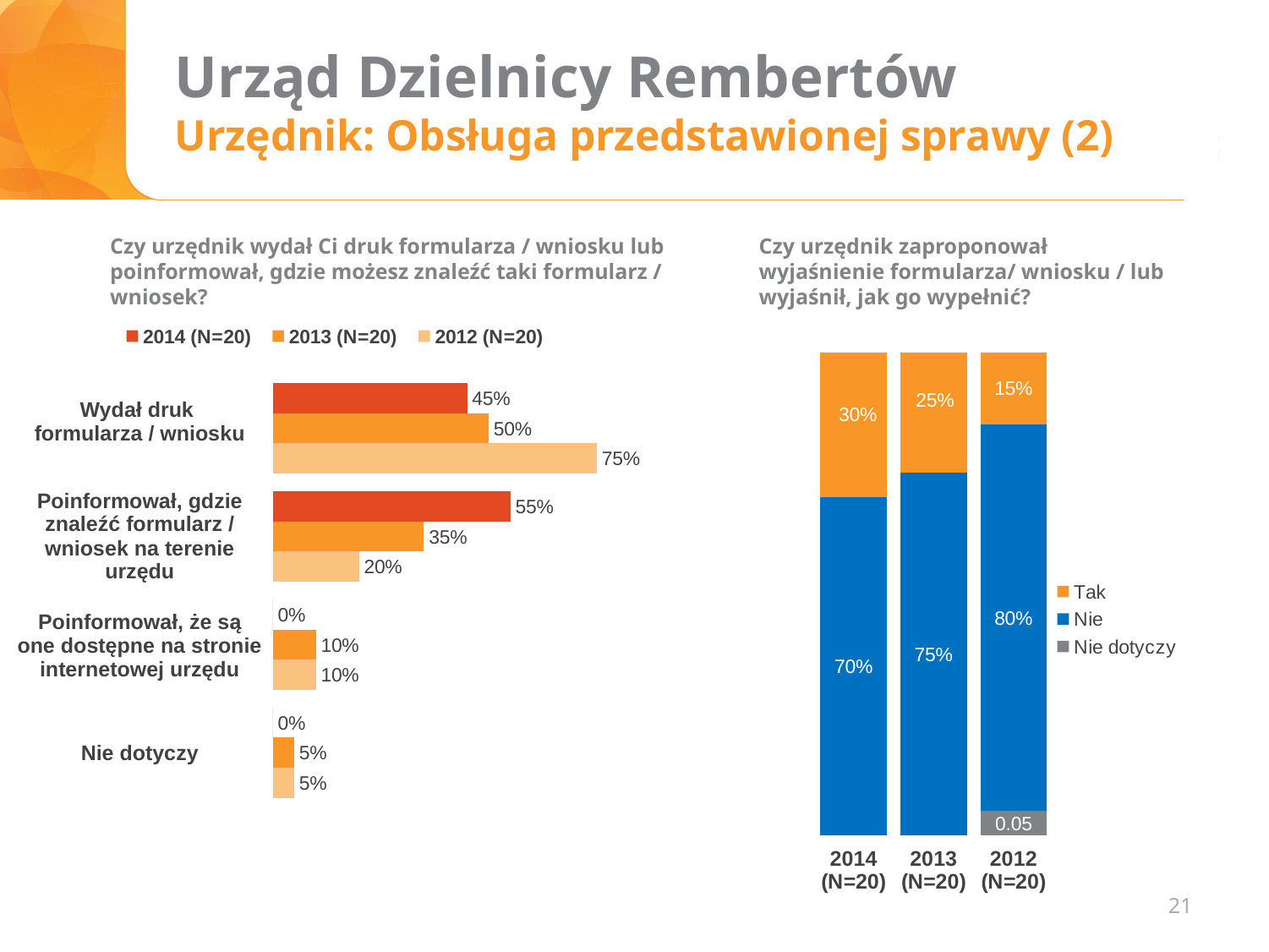
In the left chart, what is the value for 'Wydał druk formularza / wniosku' in the 2012 (N=20) series? 75% In the right chart, what is the 'Tak' value for 2014 (N=20)? 30% In the right chart, which year has the lowest 'Tak' value? 2012 (N=20) In the left chart, how many series does the legend list? 3 In the left chart, what is the value for 'Nie dotyczy' in the 2013 (N=20) series? 5% In the left chart, which category has the highest value in the 2012 (N=20) series? Wydał druk formularza / wniosku In the left chart, how many categories are shown? 4 In the right chart, what is the 'Nie' value for 2012 (N=20)? 80% In the left chart, what is the value for 'Poinformował, gdzie znaleźć formularz / wniosek na terenie urzędu' in the 2014 (N=20) series? 55% In the left chart, what is the difference between the 2012 and 2014 values for 'Wydał druk formularza / wniosku'? 30 percentage points What kind of chart is the left chart? Bar chart In the right chart, how does the 'Tak' value change from 2014 to 2012 along the x axis? It falls